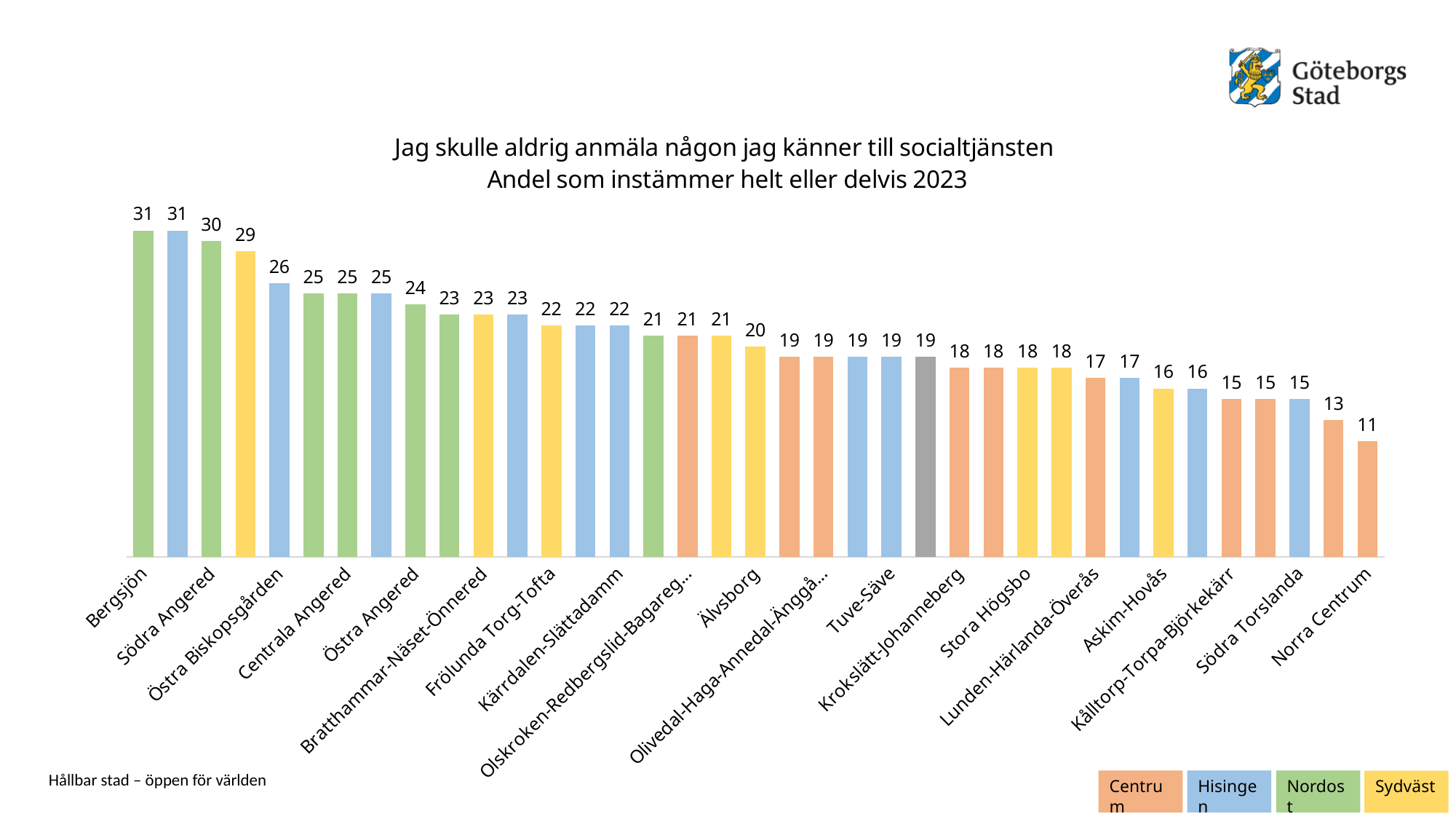
Do the values rise or fall from left to right along the x axis? fall What is the highest value shown in the chart? 31 What is the value for Norra Centrum? 11 What is the difference between the values for Bergsjön and Norra Centrum? 20 What is the value for Bergsjön? 31 What is the value for Tuve-Säve? 19 How many entries does the legend list? 4 Which is larger, the value for Södra Angered or the value for Södra Torslanda? Södra Angered What is the value for Askim-Hovås? 16 Which labelled category has the lowest value? Norra Centrum What type of chart is shown on the slide? bar chart What is the value for Södra Angered? 30